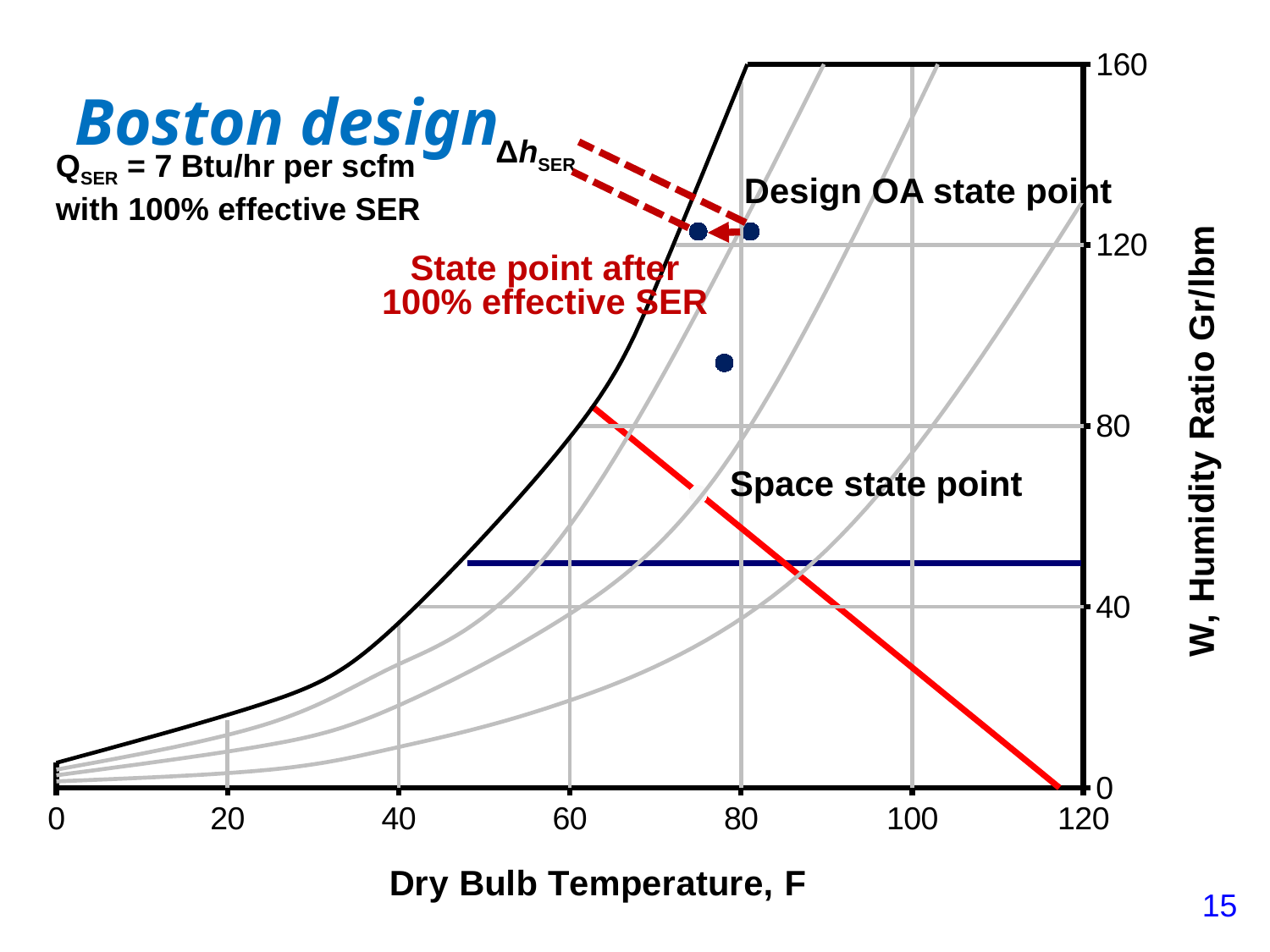
Is the humidity ratio of the Design OA state point greater or less than 80 Gr/lbm? greater What is the title of the y axis of the chart? W, Humidity Ratio Gr/lbm What is the maximum value shown on the y axis of the chart? 160 What is the title of the x axis of the chart? Dry Bulb Temperature, F Is the humidity ratio of the Space state point greater or less than 120 Gr/lbm? less How many labelled state points are plotted on the chart? 3 Which has the higher humidity ratio, the Design OA state point or the Space state point? Design OA state point Which has the higher dry bulb temperature, the Design OA state point or the state point after 100% effective SER? Design OA state point What is the maximum value shown on the x axis of the chart? 120 Does the red diagonal line rise or fall as dry bulb temperature increases? fall Is the dry bulb temperature of the Design OA state point greater or less than 60 F? greater